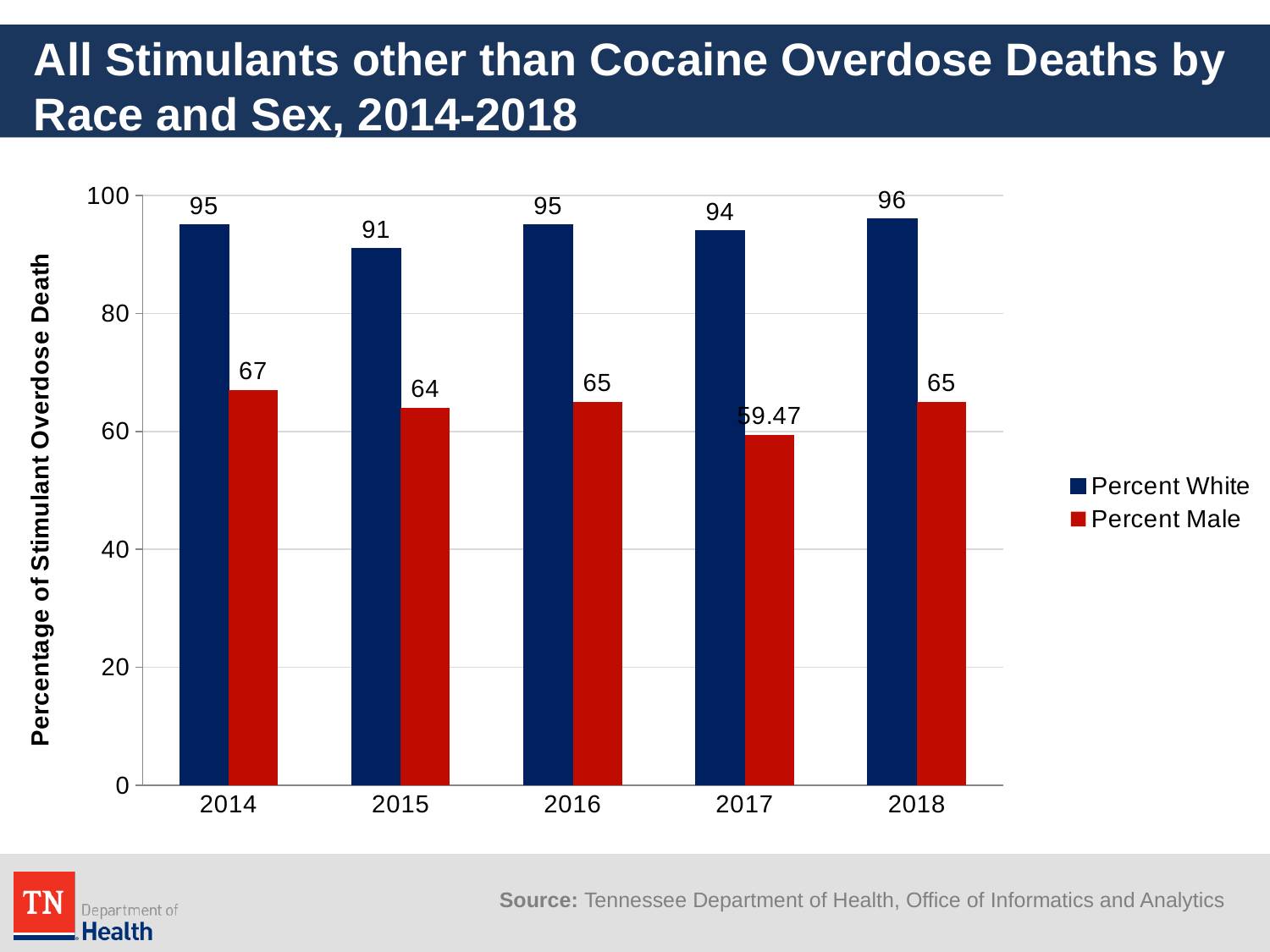
Is the Percent Male value for 2016 greater or less than 80? less What is the Percent Male value for 2017? 59.47 Which year has the lowest Percent Male value? 2017 What kind of chart is shown on the slide? bar chart Which is larger, the Percent Male value for 2014 or for 2015? 2014 Which year has the highest Percent White value? 2018 What is the label of the y axis? Percentage of Stimulant Overdose Death What is the difference between Percent White and Percent Male in 2018? 31 What is the Percent White value for 2015? 91 What is the Percent Male value for 2014? 67 How many series does the legend list? 2 How many years are shown on the x axis? 5